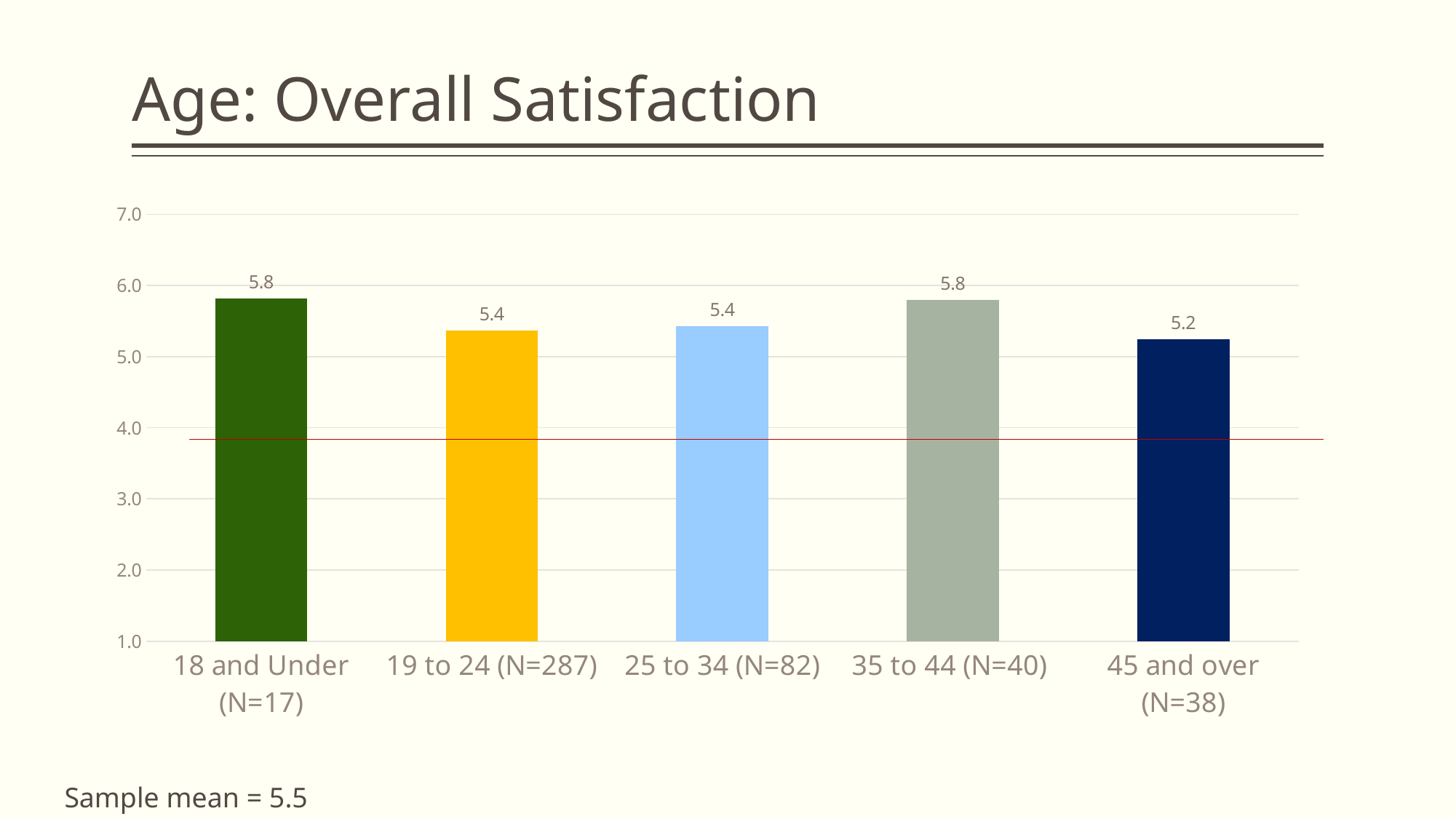
Which age group has the lowest overall satisfaction? 45 and over (N=38) What kind of chart is shown on the slide? Bar chart What is the difference between the overall satisfaction of the 18 and Under group and the 45 and over group? 0.6 Is the value for 45 and over (N=38) greater or less than 6.0? less What sample mean is stated on the slide? 5.5 What is the overall satisfaction value for the 18 and Under (N=17) group? 5.8 Which has a higher overall satisfaction value: 35 to 44 (N=40) or 25 to 34 (N=82)? 35 to 44 (N=40) What is the overall satisfaction value for the 45 and over (N=38) group? 5.2 How many age groups are shown in the chart? 5 What is the title of the chart on the slide? Age: Overall Satisfaction What is the overall satisfaction value for the 35 to 44 (N=40) group? 5.8 What is the overall satisfaction value for the 19 to 24 (N=287) group? 5.4